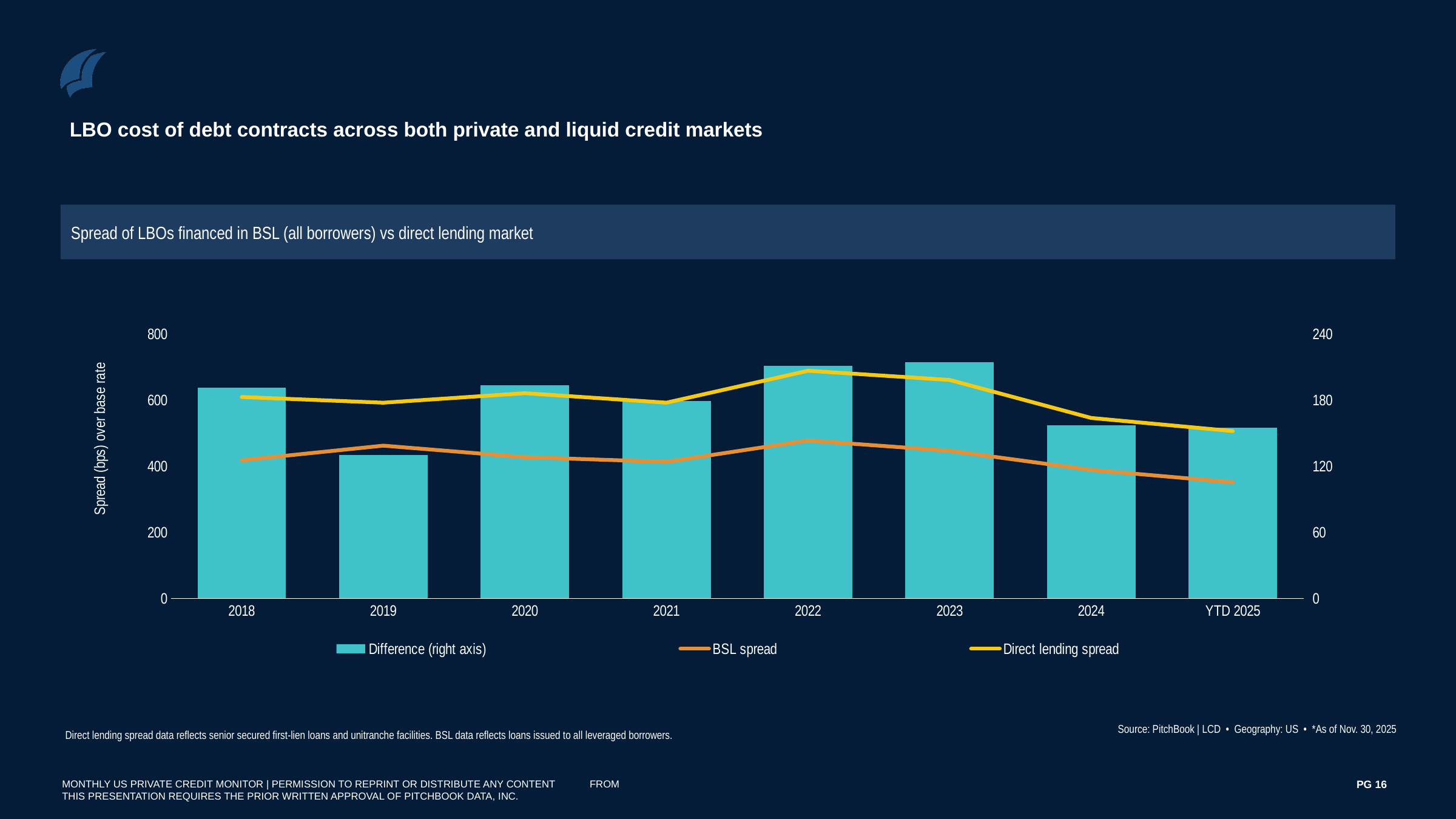
Which series is plotted as bars according to the legend? Difference (right axis) In which year does the Direct lending spread line reach its highest point? 2022 In which period is the BSL spread line at its lowest? YTD 2025 Which is larger in 2022, the Direct lending spread or the BSL spread? Direct lending spread Does the Direct lending spread rise or fall from 2023 to YTD 2025? Fall Is the Direct lending spread in 2022 greater or less than 600 bps? greater Is the BSL spread in YTD 2025 greater or less than 400 bps? less How many time periods are shown on the x axis? 8 Is the Difference bar for 2019 greater or less than 180 on the right axis? less Which year has the lowest Difference bar? 2019 How many series does the legend list? 3 What kind of chart is shown on the slide? A combination bar and line chart